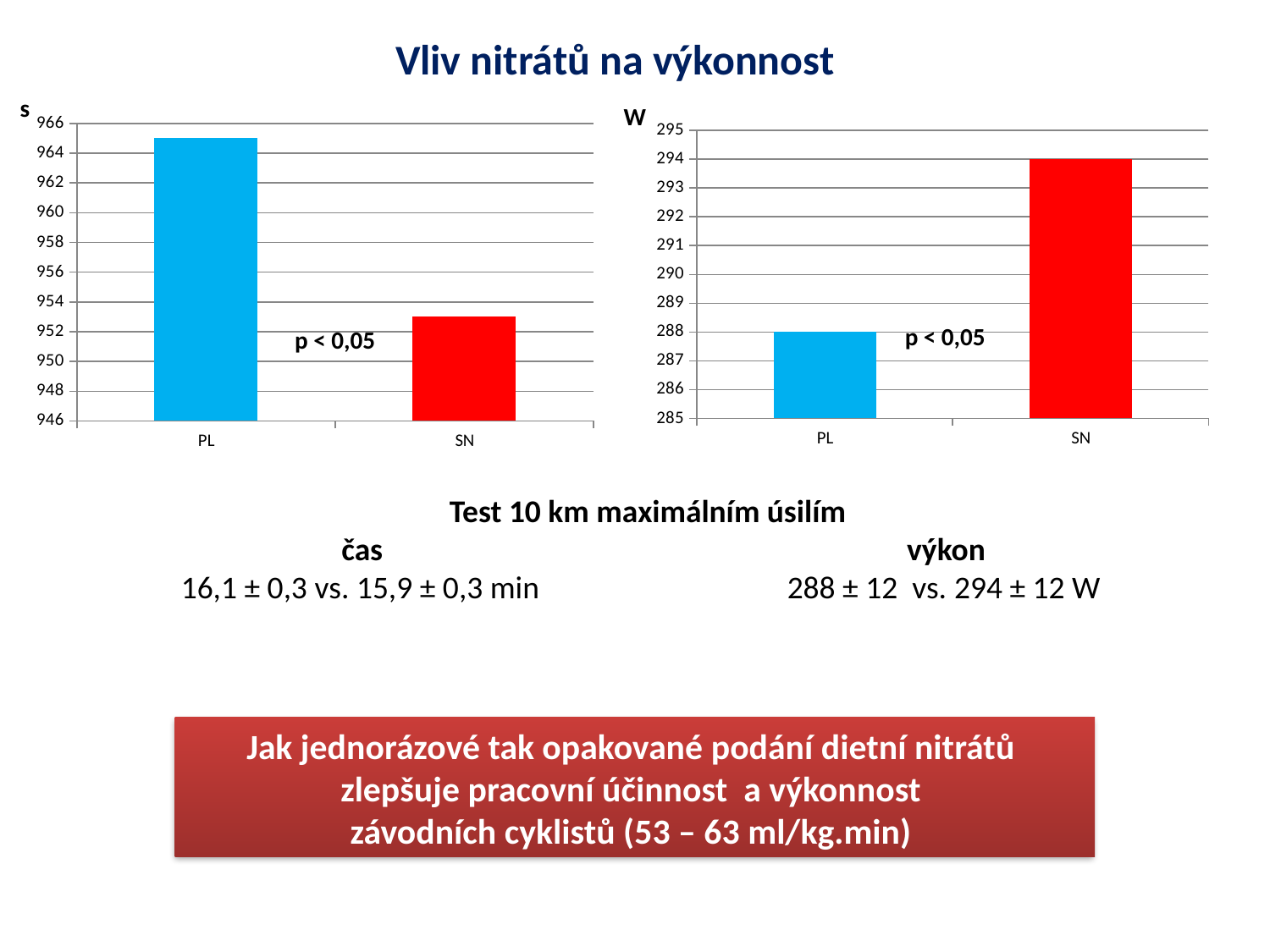
In the right chart (W axis), what is the value for SN? 294 In the left chart (s axis), which category has the lowest value? SN How many categories are shown in the left chart (s axis)? 2 In the left chart (s axis), is the value for SN greater or less than 956? less In the right chart (W axis), what is the difference between the SN and PL values? 6 What type of chart is the right chart (W axis)? bar chart In the left chart (s axis), is the value for PL greater or less than 960? greater In the right chart (W axis), is the value for PL greater or less than 290? less In the left chart (s axis), which category has the highest value? PL In the right chart (W axis), what is the value for PL? 288 What colour is the SN bar in the left chart (s axis)? red In the right chart (W axis), which category has the higher value, PL or SN? SN